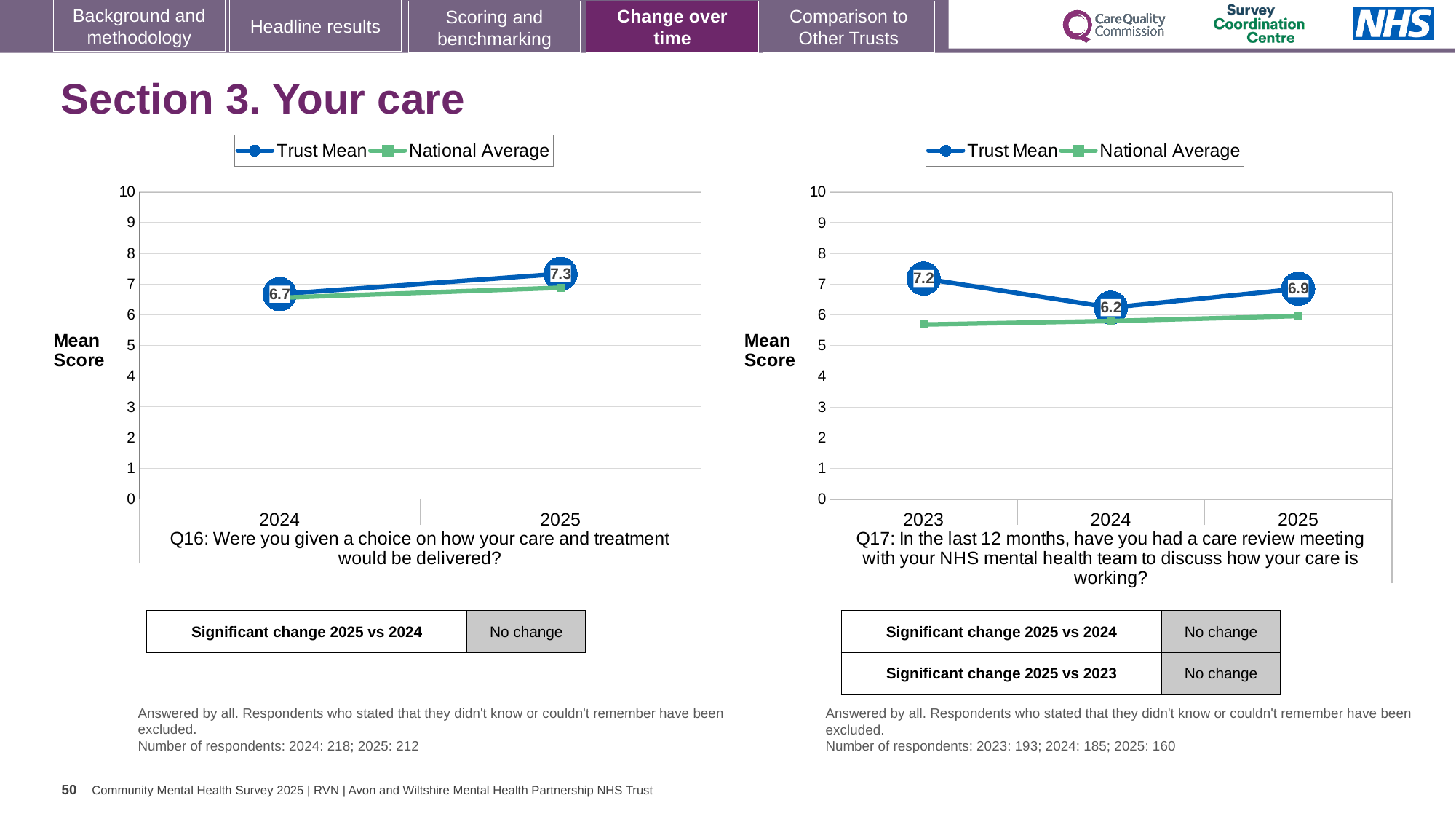
In the Q17 chart on the right, which year has the highest Trust Mean? 2023 In the Q17 chart on the right, which year has the lowest Trust Mean? 2024 In the Q17 chart on the right, is the National Average for 2023 greater or less than 6? less In the Q16 chart on the left, does the Trust Mean rise or fall from 2024 to 2025? rise In the Q17 chart on the right, what is the difference between the Trust Mean in 2023 and in 2024? 1.0 In the Q17 chart on the right, what is the Trust Mean for 2024? 6.2 In the Q17 chart on the right, what is the Trust Mean for 2023? 7.2 In the Q16 chart on the left, by how much did the Trust Mean change from 2024 to 2025? 0.6 In the Q16 chart on the left, what is the Trust Mean for 2025? 7.3 In the Q16 chart on the left, what is the Trust Mean for 2024? 6.7 How many series does the legend of the Q16 chart on the left list? 2 How many years are plotted on the x axis of the Q17 chart on the right? 3